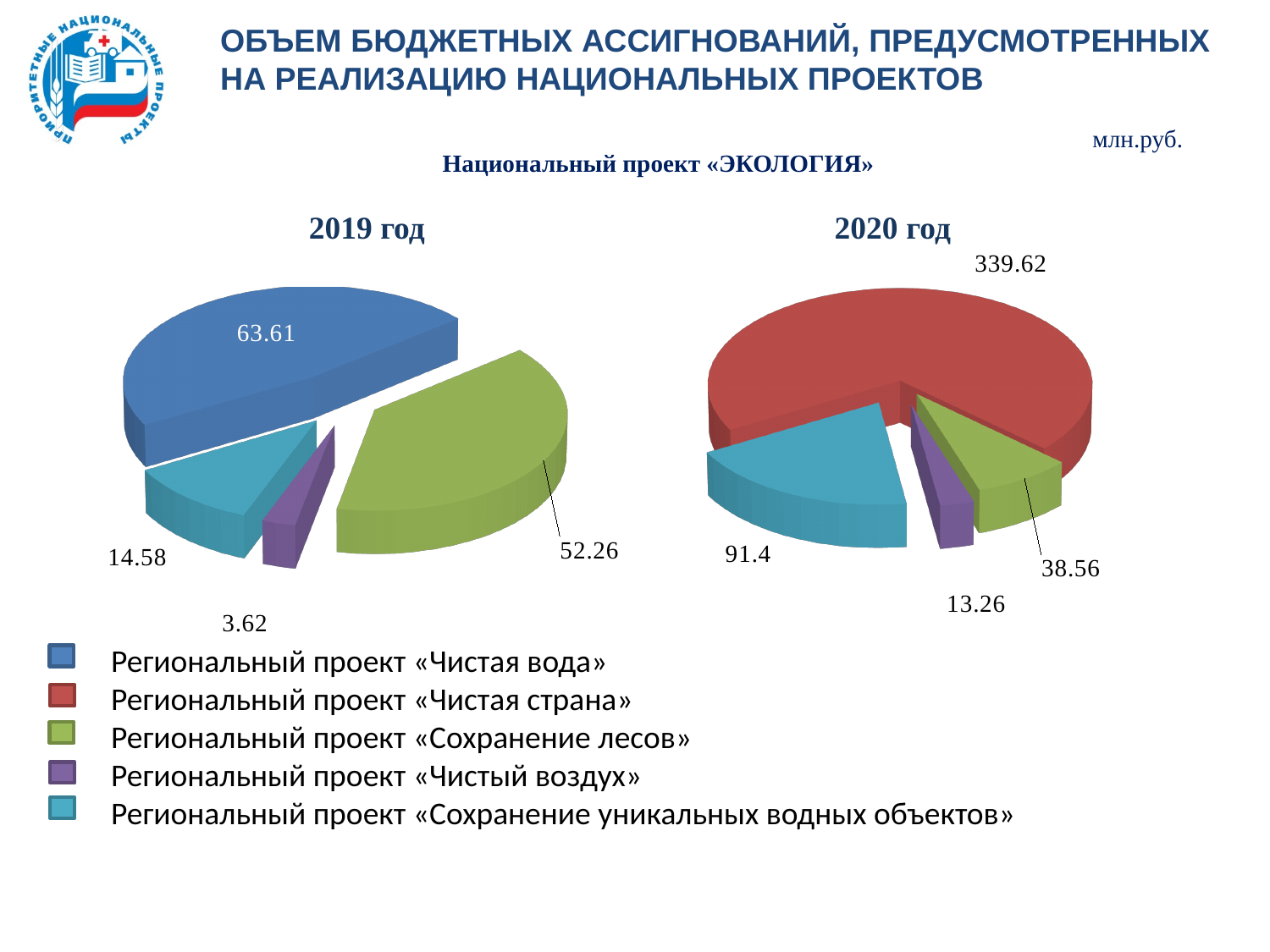
What is the total of all slices in the 2019 год chart? 134.07 In the 2020 год chart, what is the value for Региональный проект «Чистая страна»? 339.62 What type of charts are shown on the slide? Pie charts In the 2019 год chart, what is the value for Региональный проект «Чистая вода»? 63.61 In the 2020 год chart, which project has the largest slice? Региональный проект «Чистая страна» In the 2020 год chart, which is larger: the value for «Сохранение лесов» or for «Сохранение уникальных водных объектов»? Региональный проект «Сохранение уникальных водных объектов» How many slices does the 2020 год pie chart have? 4 In the 2020 год chart, what is the value for Региональный проект «Сохранение уникальных водных объектов»? 91.4 In the 2019 год chart, what is the value for Региональный проект «Чистый воздух»? 3.62 In the 2019 год chart, what is the difference between the values for «Чистая вода» and «Сохранение лесов»? 11.35 In the 2019 год chart, which project has the smallest slice? Региональный проект «Чистый воздух» How many projects does the legend list? 5